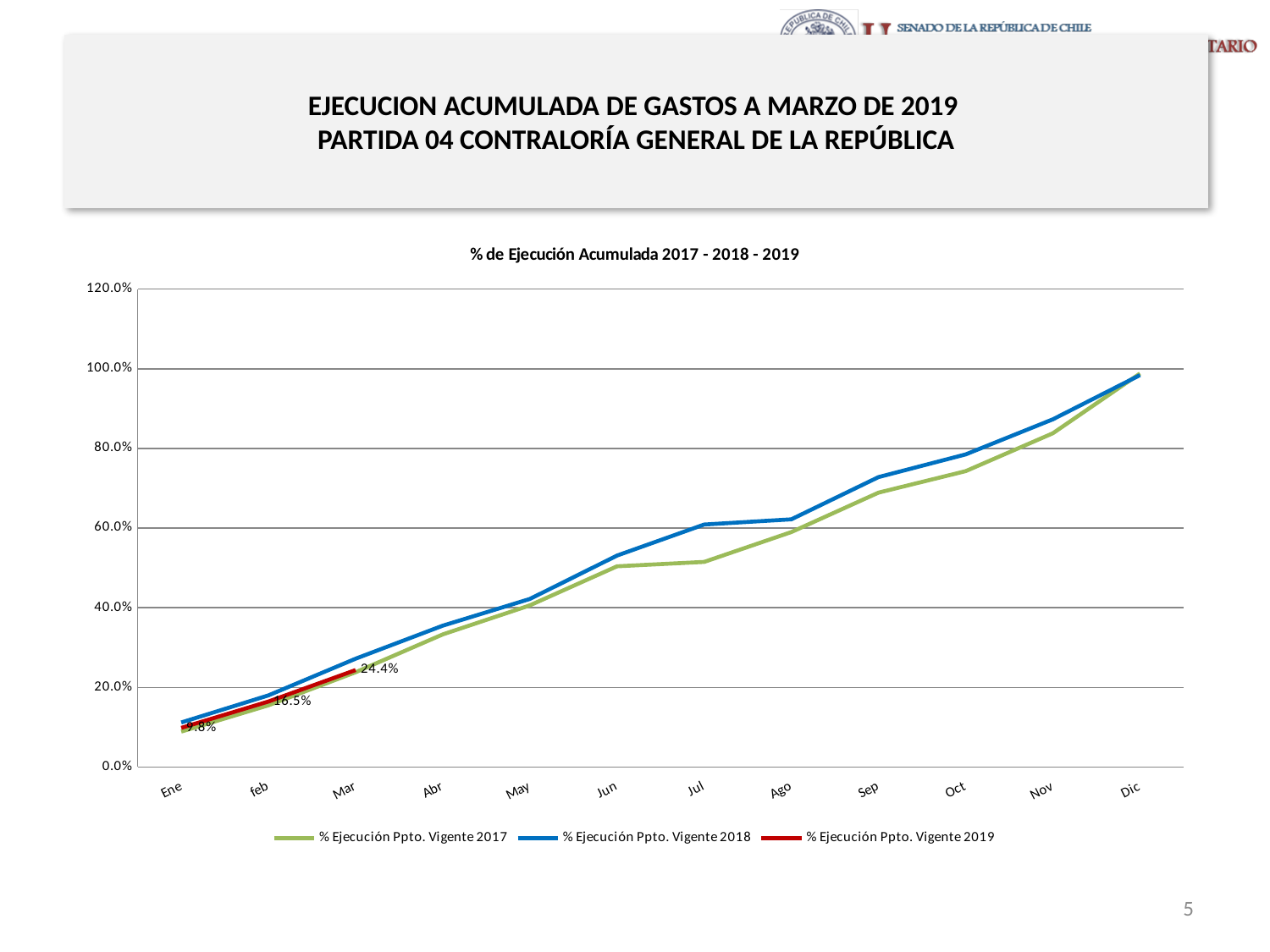
How many months are shown along the x axis? 12 What is the difference between the 2019 values for Mar and feb? 7.9% How many series does the legend list? 3 What is the value of % Ejecución Ppto. Vigente 2019 in Mar? 24.4% In Jul, which series is higher: % Ejecución Ppto. Vigente 2017 or % Ejecución Ppto. Vigente 2018? % Ejecución Ppto. Vigente 2018 Is the value for % Ejecución Ppto. Vigente 2017 in Oct greater or less than 80.0%? less Do the values of % Ejecución Ppto. Vigente 2018 rise or fall from Ene to Dic? rise What is the title of the chart? % de Ejecución Acumulada 2017 - 2018 - 2019 What kind of chart is shown on the slide? line chart Is the value for % Ejecución Ppto. Vigente 2018 in Dic greater or less than 80.0%? greater What is the value of % Ejecución Ppto. Vigente 2019 in feb? 16.5% Is the value for % Ejecución Ppto. Vigente 2017 in Jul greater or less than 60.0%? less